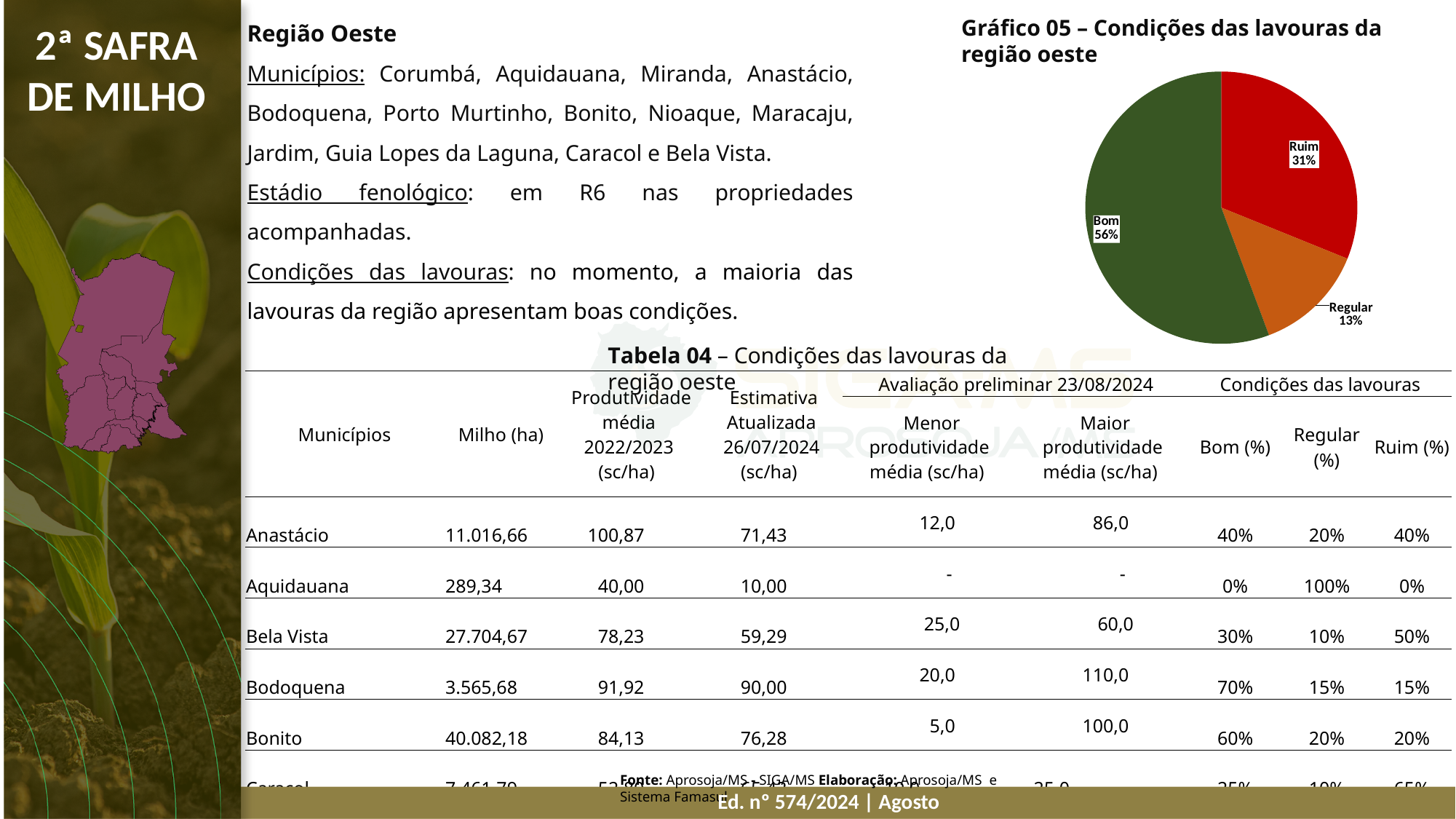
How many slices does the pie chart 'Gráfico 05 – Condições das lavouras da região oeste' have? 3 Which category has the smallest slice in the pie chart 'Gráfico 05'? Regular In the pie chart 'Gráfico 05', which is larger, the Ruim slice or the Regular slice? Ruim Which category has the largest slice in the pie chart 'Gráfico 05 – Condições das lavouras da região oeste'? Bom In the pie chart 'Gráfico 05', what percentage is shown for Regular? 13% What share of the pie chart 'Gráfico 05 – Condições das lavouras da região oeste' is labelled Bom? 56% In the pie chart 'Gráfico 05', what percentage is shown for Ruim? 31% In the pie chart 'Gráfico 05', what is the difference in percentage points between Ruim and Regular? 18 In the pie chart 'Gráfico 05', what is the difference in percentage points between Bom and Ruim? 25 What type of chart is 'Gráfico 05 – Condições das lavouras da região oeste'? Pie chart In the pie chart 'Gráfico 05', what colour is the Bom slice? Green In the pie chart 'Gráfico 05', what colour is the Ruim slice? Red